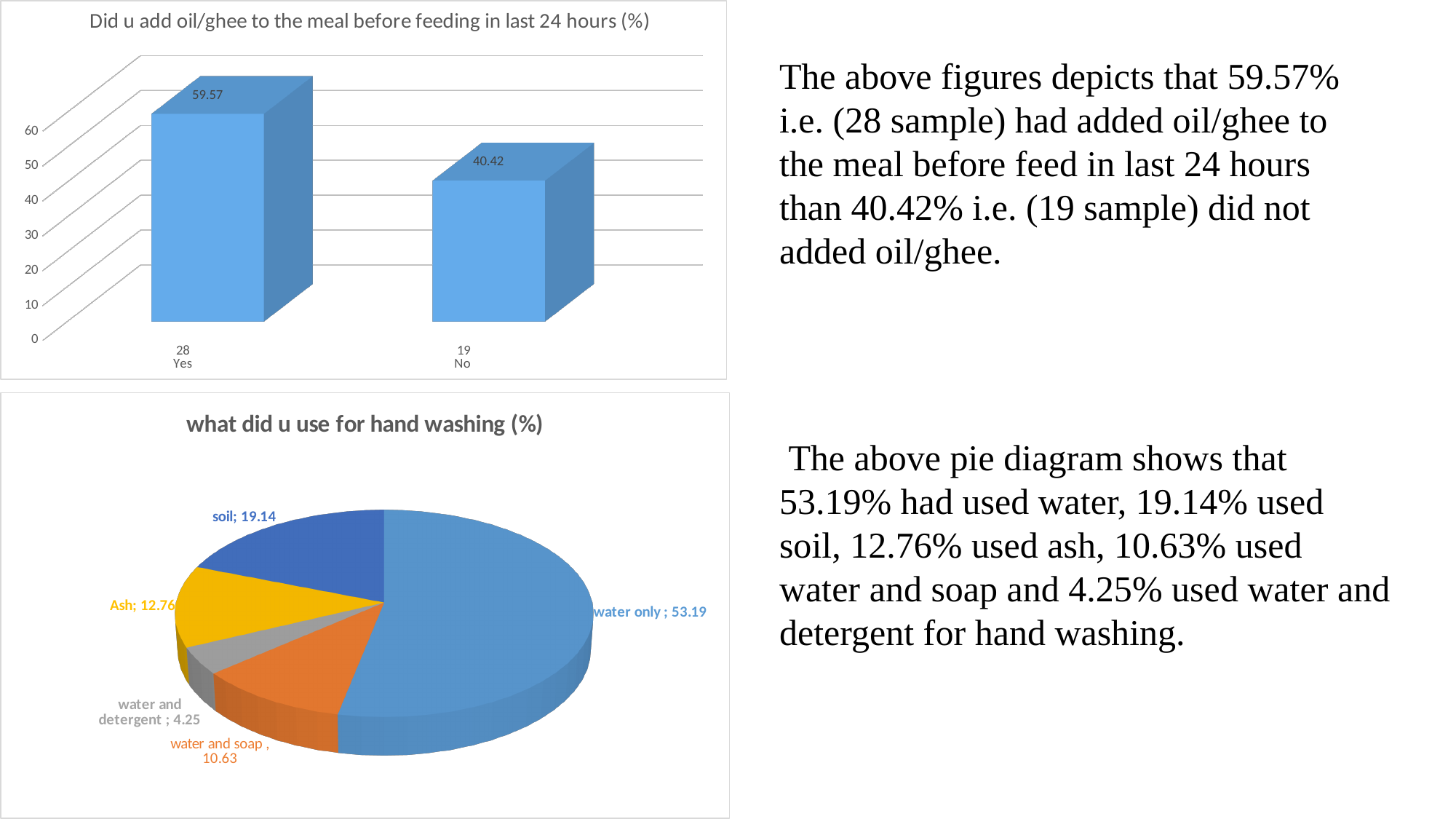
In the chart titled 'Did u add oil/ghee to the meal before feeding in last 24 hours (%)', what is the value for Yes? 59.57 In the chart titled 'Did u add oil/ghee to the meal before feeding in last 24 hours (%)', what is the difference between the Yes and No values? 19.15 In the chart titled 'Did u add oil/ghee to the meal before feeding in last 24 hours (%)', how many categories are shown? 2 In the chart titled 'what did u use for hand washing (%)', which category has the smallest slice? water and detergent What kind of chart is the chart titled 'what did u use for hand washing (%)'? Pie chart In the chart titled 'what did u use for hand washing (%)', how many slices does the pie have? 5 In the chart titled 'what did u use for hand washing (%)', what is the value for water and detergent? 4.25 In the chart titled 'Did u add oil/ghee to the meal before feeding in last 24 hours (%)', what is the value for No? 40.42 In the chart titled 'what did u use for hand washing (%)', what is the value for soil? 19.14 What kind of chart is the top chart on the slide? Bar chart In the chart titled 'what did u use for hand washing (%)', which category has the largest slice? water only In the chart titled 'Did u add oil/ghee to the meal before feeding in last 24 hours (%)', which category has the higher value? Yes